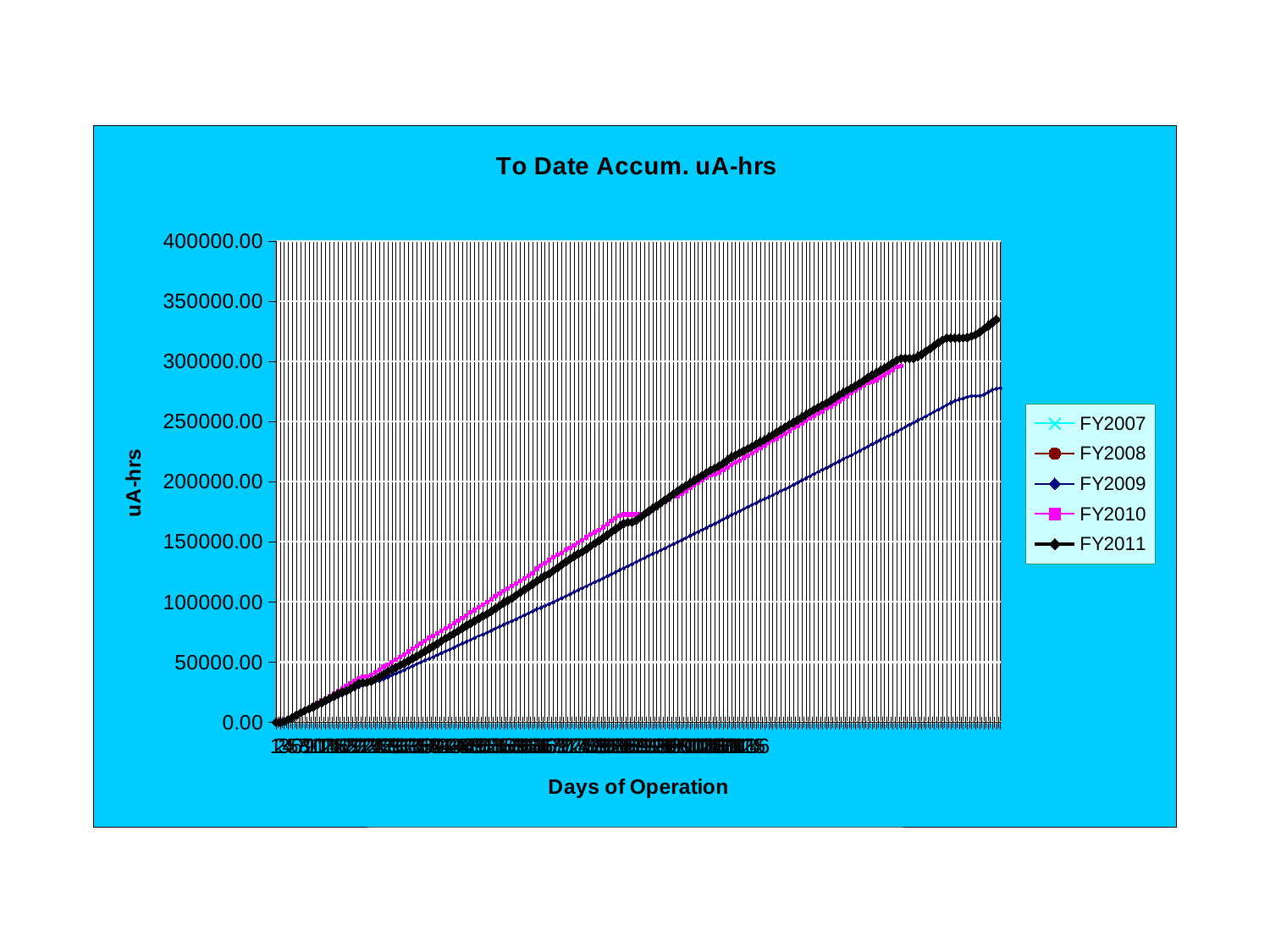
Is the highest value reached by FY2011 greater or less than 300000.00? greater Is the highest value reached by FY2011 greater or less than 350000.00? less Is the highest value reached by FY2009 greater or less than 250000.00? greater Which series reaches the highest value on the chart? FY2011 What is the label on the vertical axis? uA-hrs Which series reaches a higher final value, FY2009 or FY2011? FY2011 What kind of chart is shown on the slide? line chart What is the title of the chart? To Date Accum. uA-hrs Do the values for FY2011 rise or fall as the days of operation increase? rise How many series does the legend list? 5